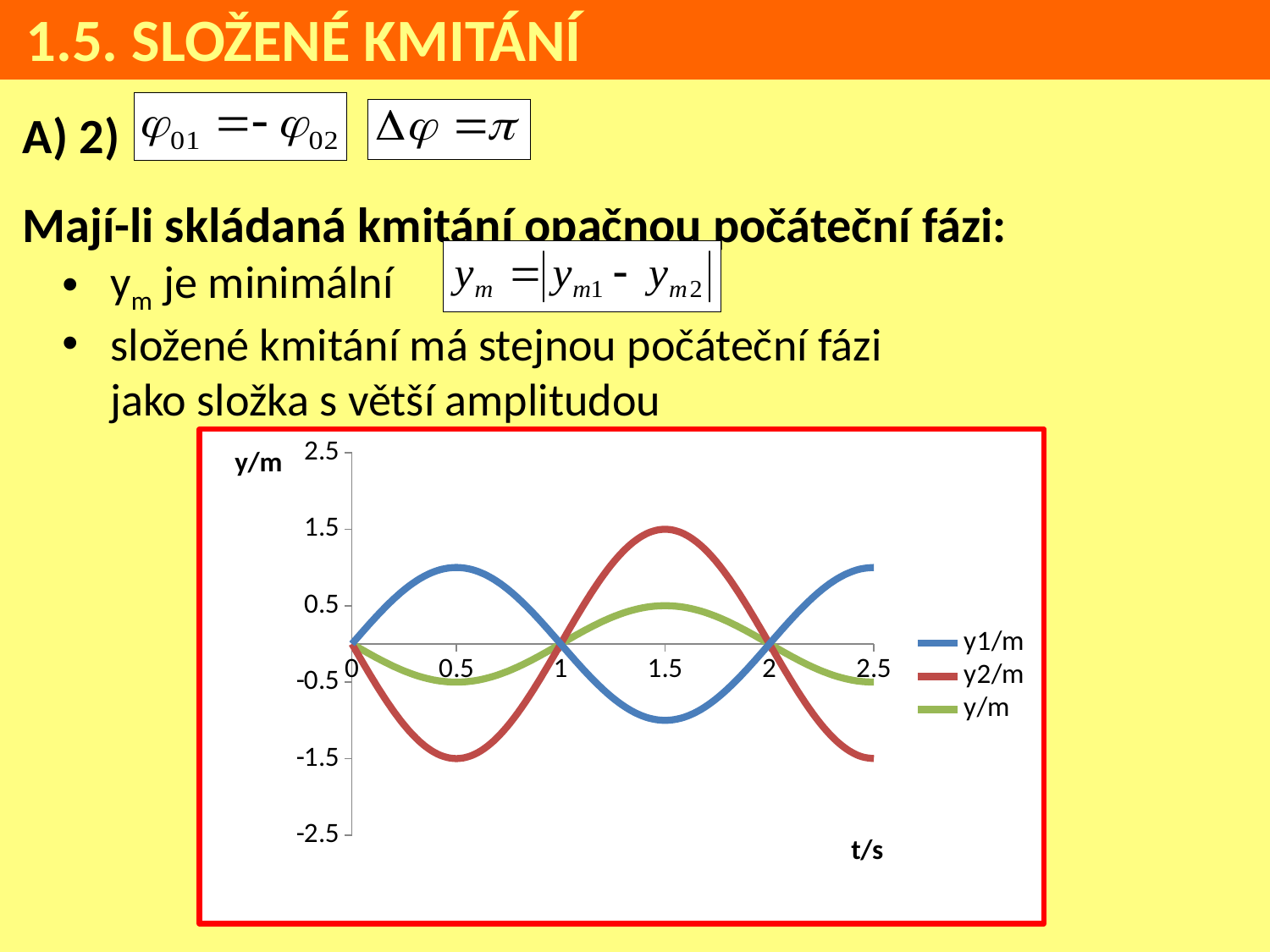
What kind of chart is shown on the slide? line chart What is the value of y/m at t = 1.5 s? 0.5 What is the label of the horizontal axis of the chart? t/s How many series does the chart legend list? 3 What are the three series named in the chart legend? y1/m, y2/m, y/m What is the difference between y2/m and y/m at t = 1.5 s? 1 What is the value of y2/m at t = 1.5 s? 1.5 Is the value of y1/m at t = 0.5 s greater or less than 0.5? greater At t = 1.5 s, which is larger, y2/m or y/m? y2/m What is the value of y/m at t = 0.5 s? -0.5 Which series reaches the highest value on the chart? y2/m What is the value of y2/m at t = 0.5 s? -1.5